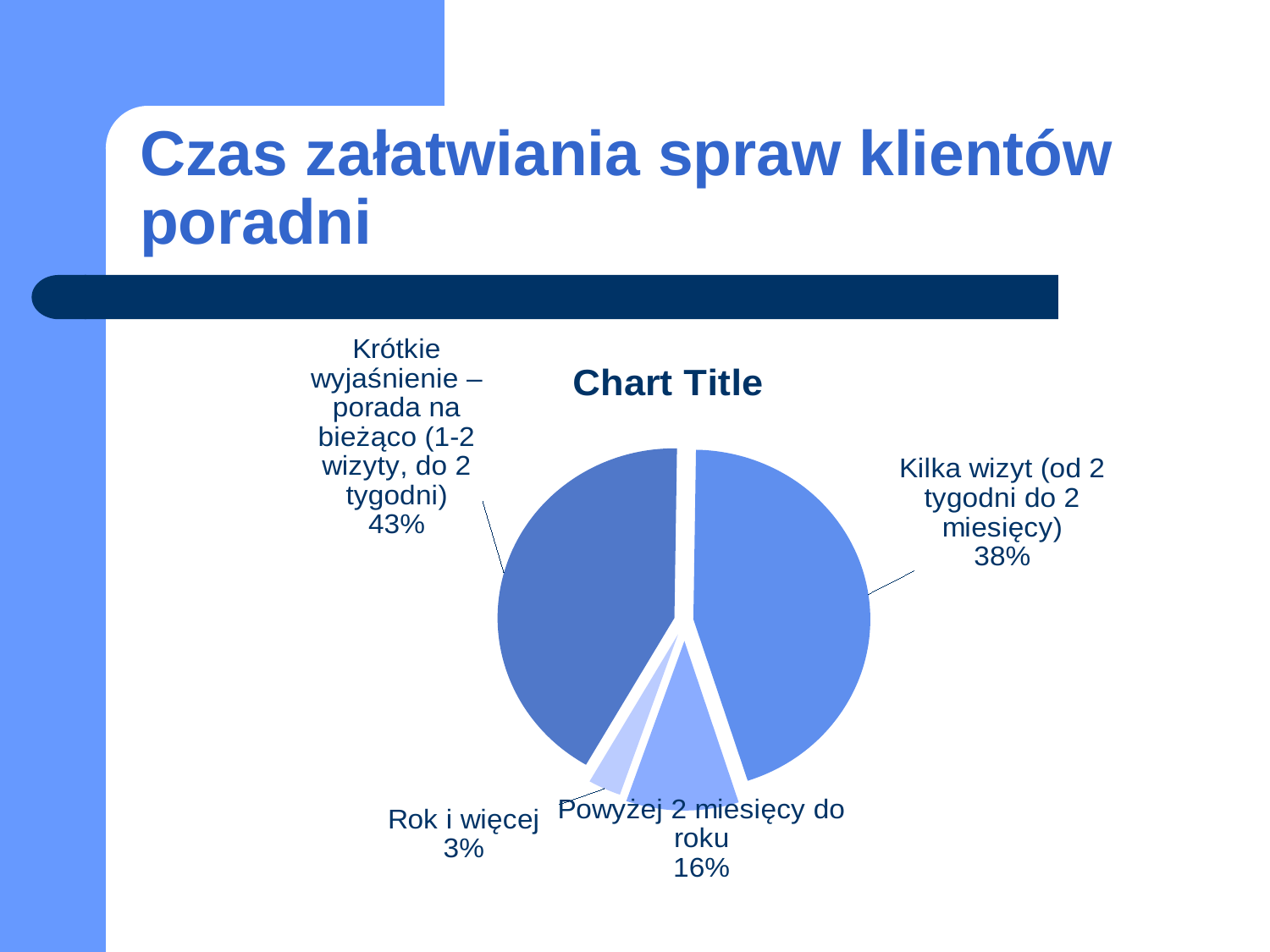
What kind of chart is shown on the slide? Pie chart What share of the pie does "Rok i więcej" represent? 3% Which is larger: the share for "Kilka wizyt (od 2 tygodni do 2 miesięcy)" or the share for "Powyżej 2 miesięcy do roku"? Kilka wizyt (od 2 tygodni do 2 miesięcy) What share of the pie does "Krótkie wyjaśnienie – porada na bieżąco (1-2 wizyty, do 2 tygodni)" represent? 43% What is the difference in percentage points between "Powyżej 2 miesięcy do roku" and "Rok i więcej"? 13 percentage points What is the title printed above the pie chart? Chart Title What is the difference in percentage points between "Krótkie wyjaśnienie – porada na bieżąco" and "Kilka wizyt (od 2 tygodni do 2 miesięcy)"? 5 percentage points What share of the pie does "Powyżej 2 miesięcy do roku" represent? 16% Which category has the smallest slice of the pie? Rok i więcej How many categories are shown in the pie chart? 4